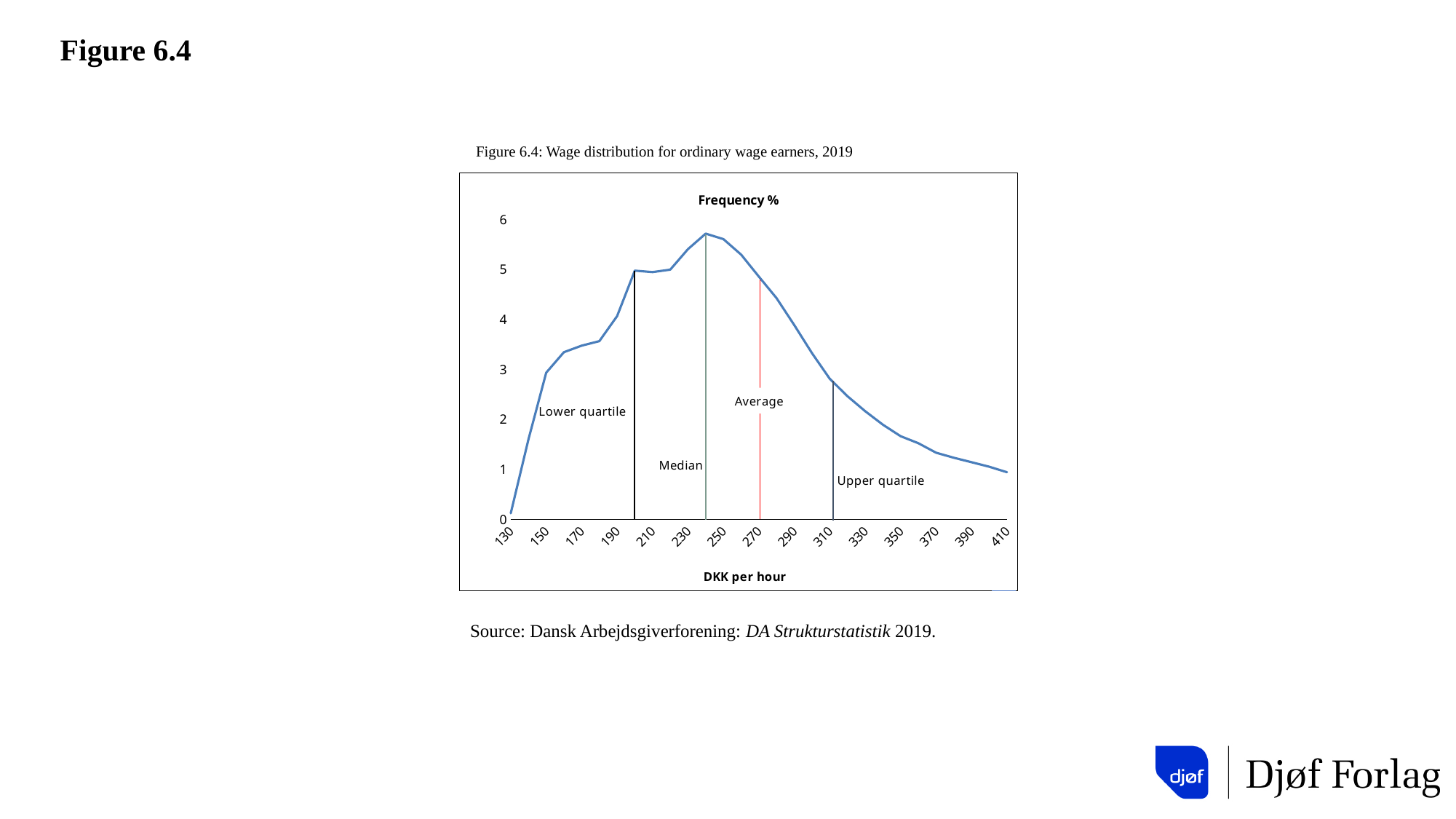
Which has the higher frequency, 250 DKK per hour or 150 DKK per hour? 250 Is the frequency at 350 DKK per hour greater or less than 2? less Is the frequency at 370 DKK per hour greater or less than 1? greater Is the frequency at 170 DKK per hour greater or less than 3? greater What is the label on the x axis of the chart? DKK per hour What kind of chart is shown in Figure 6.4? line chart Do the frequency values rise or fall as DKK per hour increases from 250 to 410? fall Which of the four vertical marker lines on the chart is drawn in red? Average How many tick labels are shown on the x axis of the chart? 15 Which has the higher frequency, 190 DKK per hour or 390 DKK per hour? 190